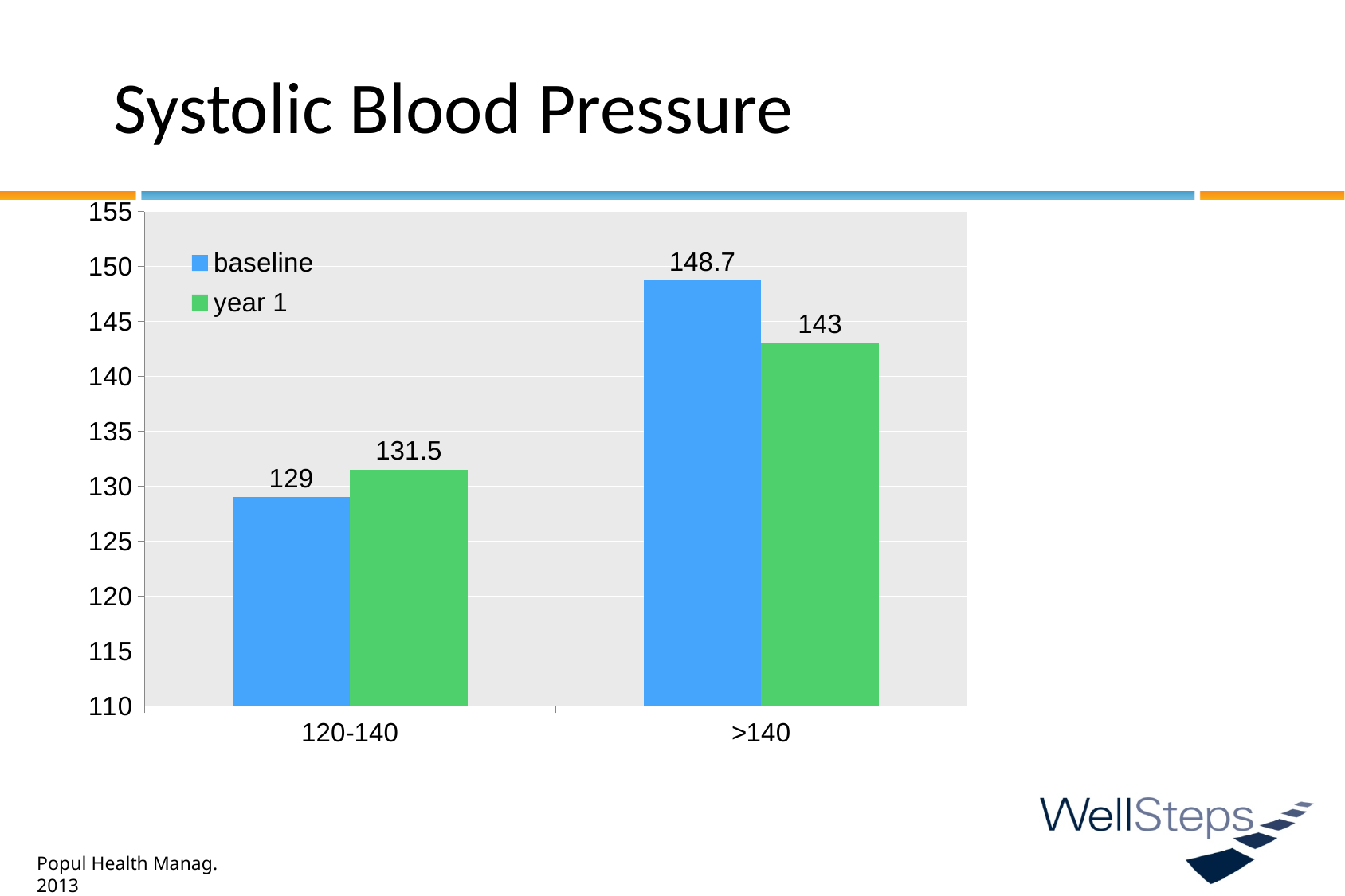
Which group has the highest baseline value? >140 What is the year 1 value for the 120-140 group? 131.5 Which group has the lowest year 1 value? 120-140 How many groups are shown on the x axis? 2 What is the baseline value for the >140 group? 148.7 What is the baseline value for the 120-140 group? 129 What is the difference between the baseline and year 1 values for the >140 group? 5.7 How many series does the legend list? 2 What is the difference between the year 1 and baseline values for the 120-140 group? 2.5 What kind of chart is shown on the slide? bar chart What is the year 1 value for the >140 group? 143 For the >140 group, which is larger: the baseline value or the year 1 value? baseline